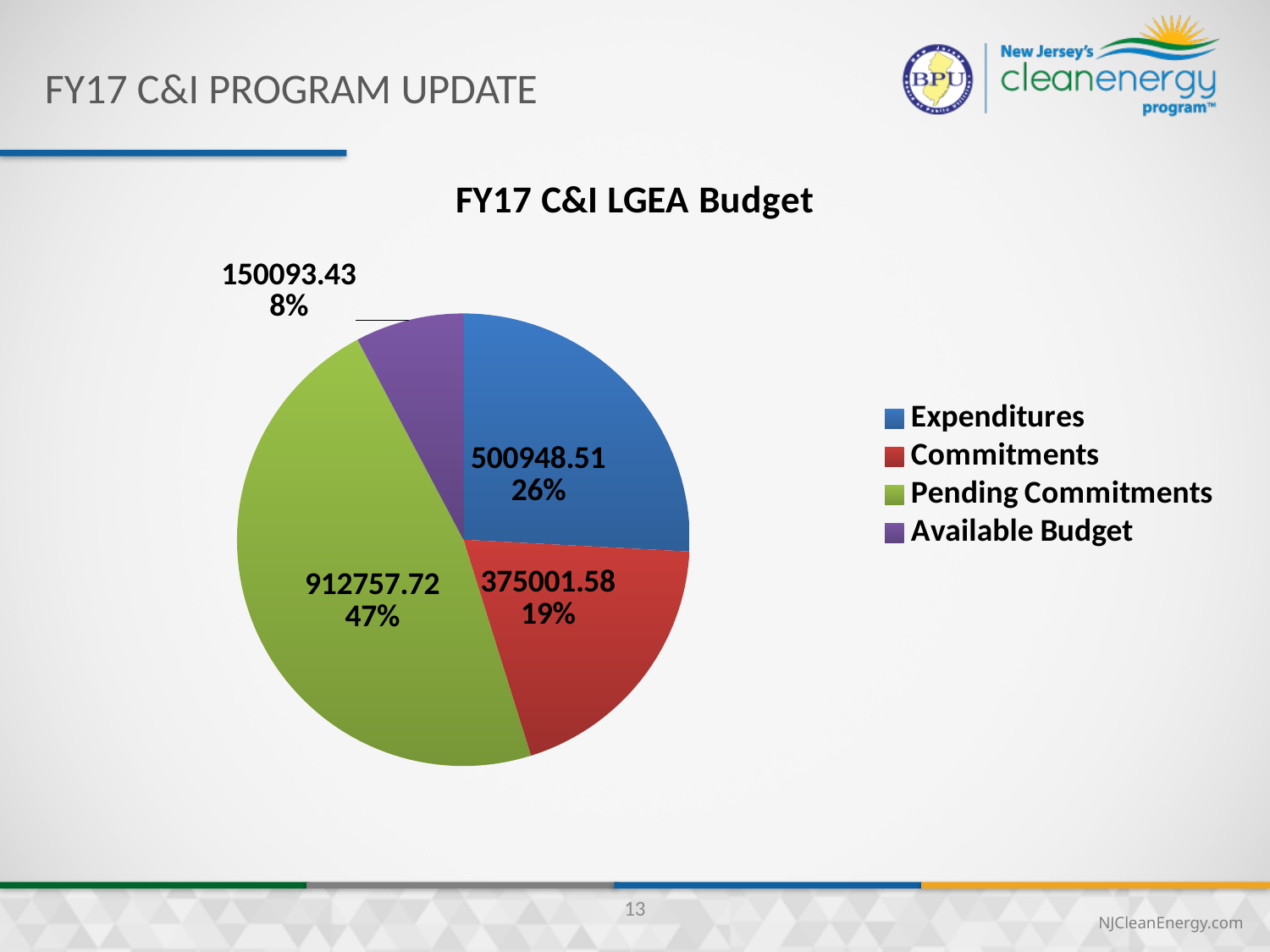
Which is larger, Expenditures or Commitments? Expenditures What is the difference between the Pending Commitments value and the Expenditures value? 411809.21 What is the title of the chart? FY17 C&I LGEA Budget What share of the pie does Commitments represent? 19% How many categories does the legend list? 4 What is the value for Available Budget? 150093.43 What share of the pie does Pending Commitments represent? 47% Which category has the smallest slice of the pie? Available Budget What kind of chart is shown on the slide? Pie chart What is the value for Expenditures? 500948.51 What is the value for Pending Commitments? 912757.72 Which category has the largest slice of the pie? Pending Commitments